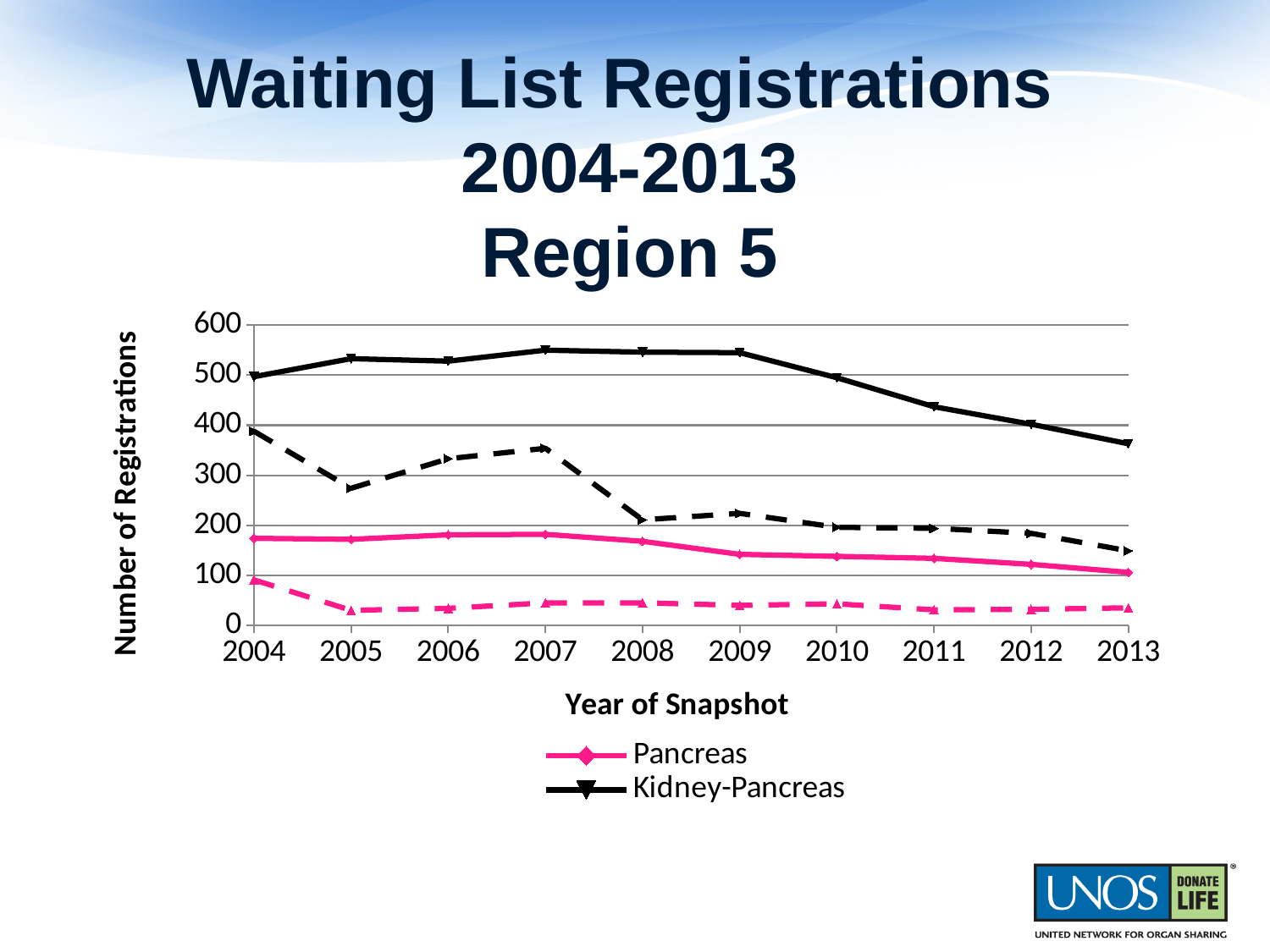
In which year is the Kidney-Pancreas value lowest? 2013 Is the Kidney-Pancreas value for 2007 greater or less than 500? greater Is the Pancreas value for 2009 greater or less than 100? greater Do the Kidney-Pancreas values rise or fall from 2009 to 2013? fall What kind of chart is shown on the slide? line chart What is the label of the y axis? Number of Registrations Is the Kidney-Pancreas value for 2013 greater or less than 400? less Which is larger for Kidney-Pancreas, the value for 2010 or the value for 2013? 2010 How many series does the legend list? 2 How many years are shown along the x axis? 10